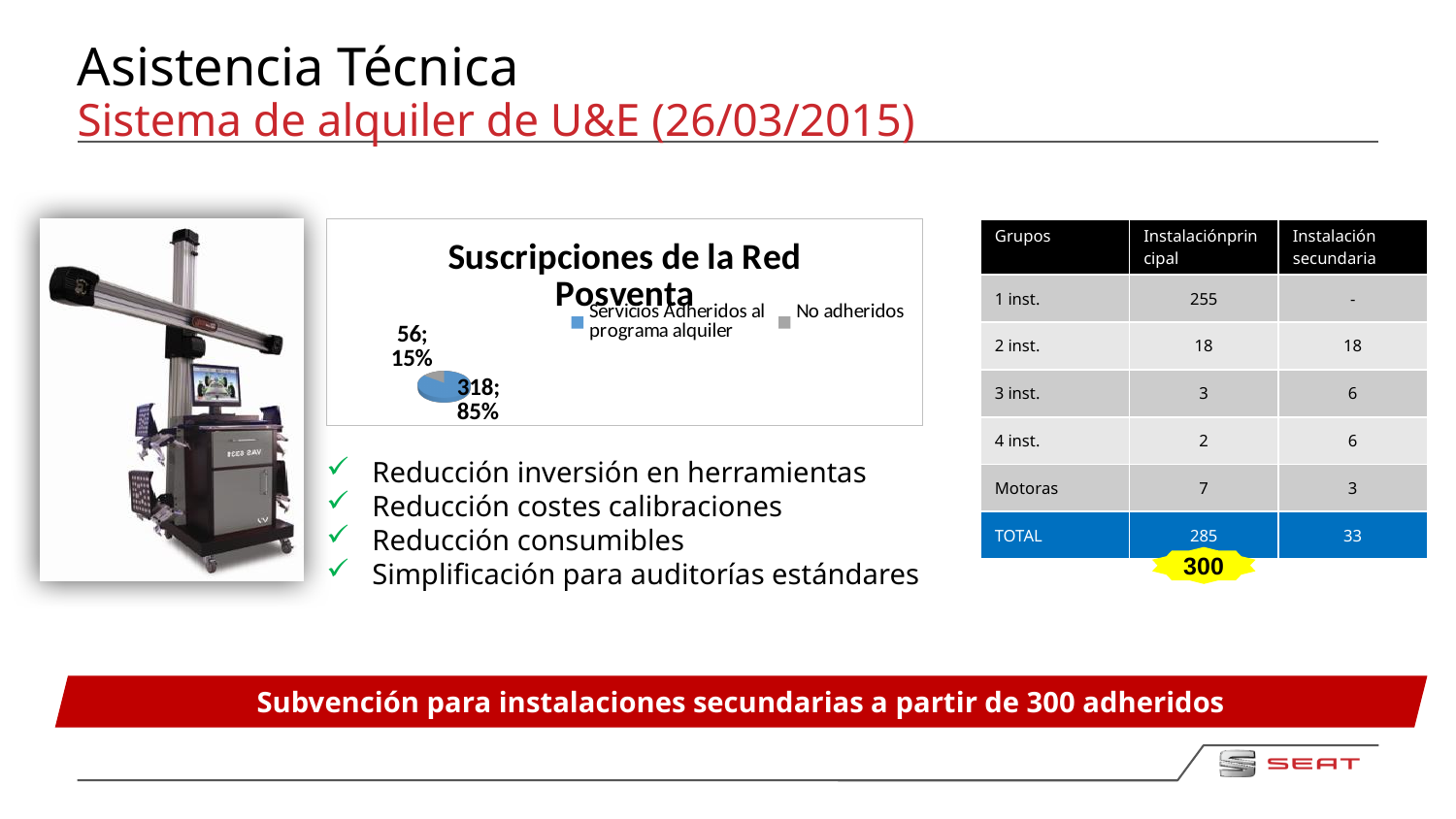
What is the difference between the values for 'Servicios Adheridos al programa alquiler' and 'No adheridos' in the pie chart? 262 Which is larger in the pie chart: 'Servicios Adheridos al programa alquiler' or 'No adheridos'? Servicios Adheridos al programa alquiler What is the value for 'Servicios Adheridos al programa alquiler' in the pie chart? 318 Which slice of the pie chart is the smallest? No adheridos What share of the pie does 'Servicios Adheridos al programa alquiler' represent? 85% What is the title of the pie chart? Suscripciones de la Red Posventa What kind of chart is shown on the slide? pie chart How many slices does the pie chart have? 2 How many entries does the pie chart legend list? 2 What share of the pie does 'No adheridos' represent? 15% Which slice of the pie chart is the largest? Servicios Adheridos al programa alquiler What is the value for 'No adheridos' in the pie chart? 56